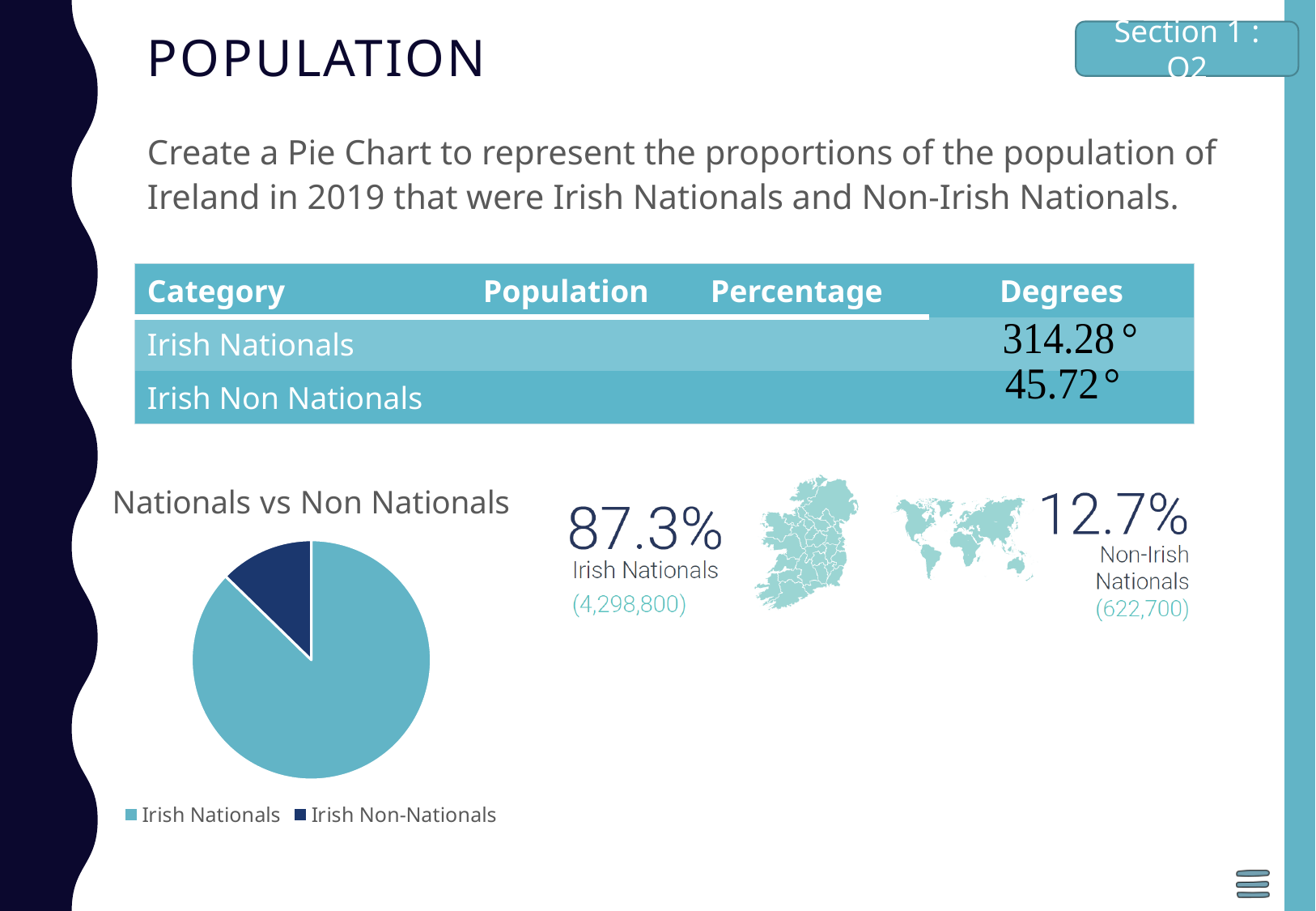
Which category has the smallest slice in the pie chart? Irish Non-Nationals Does the Irish Nationals slice take up more or less than half of the pie chart? more Which category has the largest slice in the pie chart? Irish Nationals Which legend entry is shown in dark blue in the pie chart? Irish Non-Nationals How many entries does the pie chart's legend list? 2 What is the title of the pie chart? Nationals vs Non Nationals How many slices does the pie chart have? 2 In the pie chart, which slice is larger: Irish Nationals or Irish Non-Nationals? Irish Nationals What kind of chart is shown on the slide? pie chart